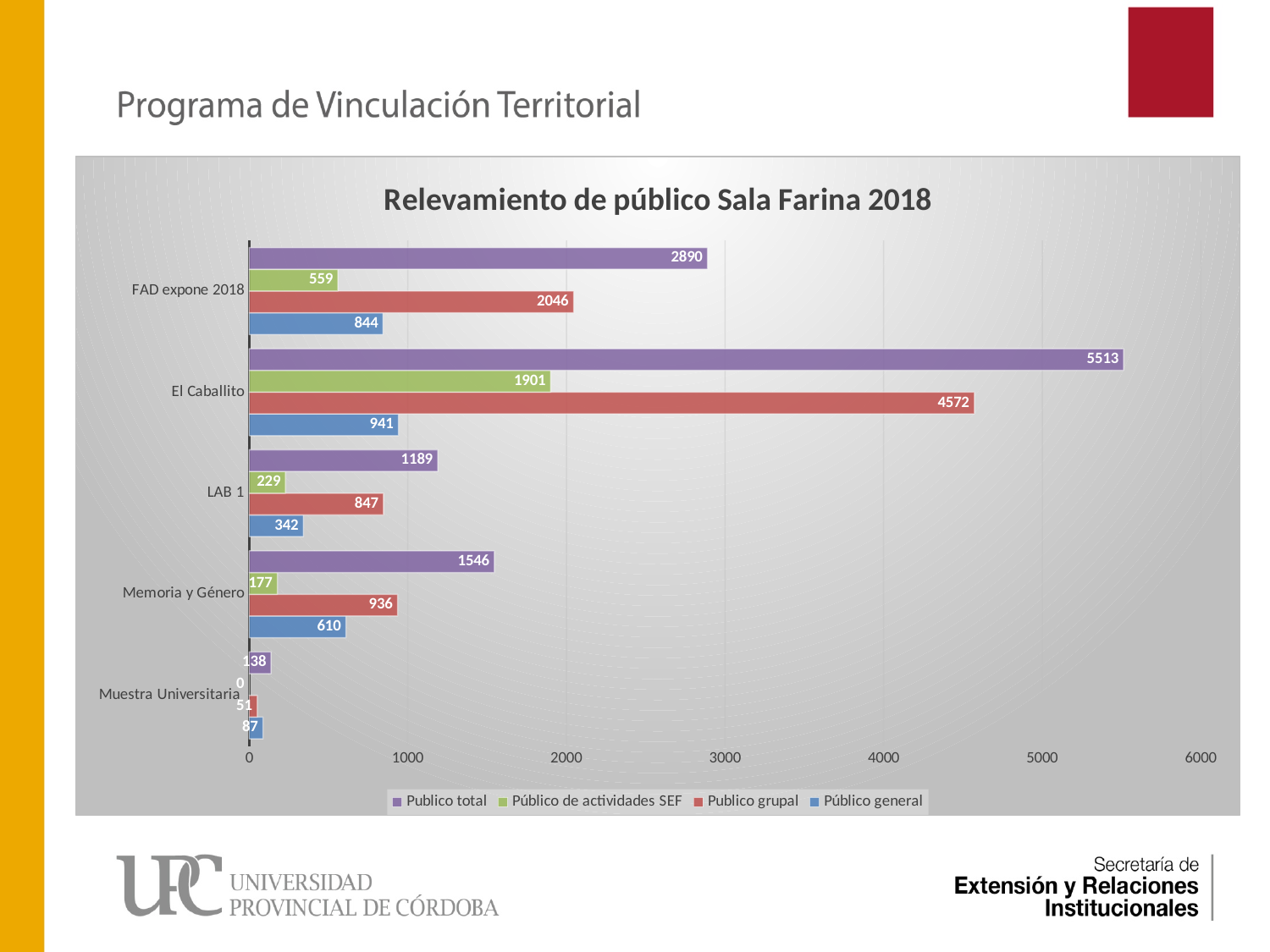
What is the Público general value for FAD expone 2018? 844 What is the Publico total value for El Caballito? 5513 How many series does the legend list? 4 What is the Público de actividades SEF value for Muestra Universitaria? 0 Which category has the highest Publico total? El Caballito Which category has the lowest Publico grupal? Muestra Universitaria What kind of chart is shown? Bar chart What is the title of the chart? Relevamiento de público Sala Farina 2018 How many categories are shown on the y axis? 5 What is the Publico grupal value for LAB 1? 847 Which is larger: the Público general value for Memoria y Género or for LAB 1? Memoria y Género What is the difference between the Publico grupal values for El Caballito and FAD expone 2018? 2526